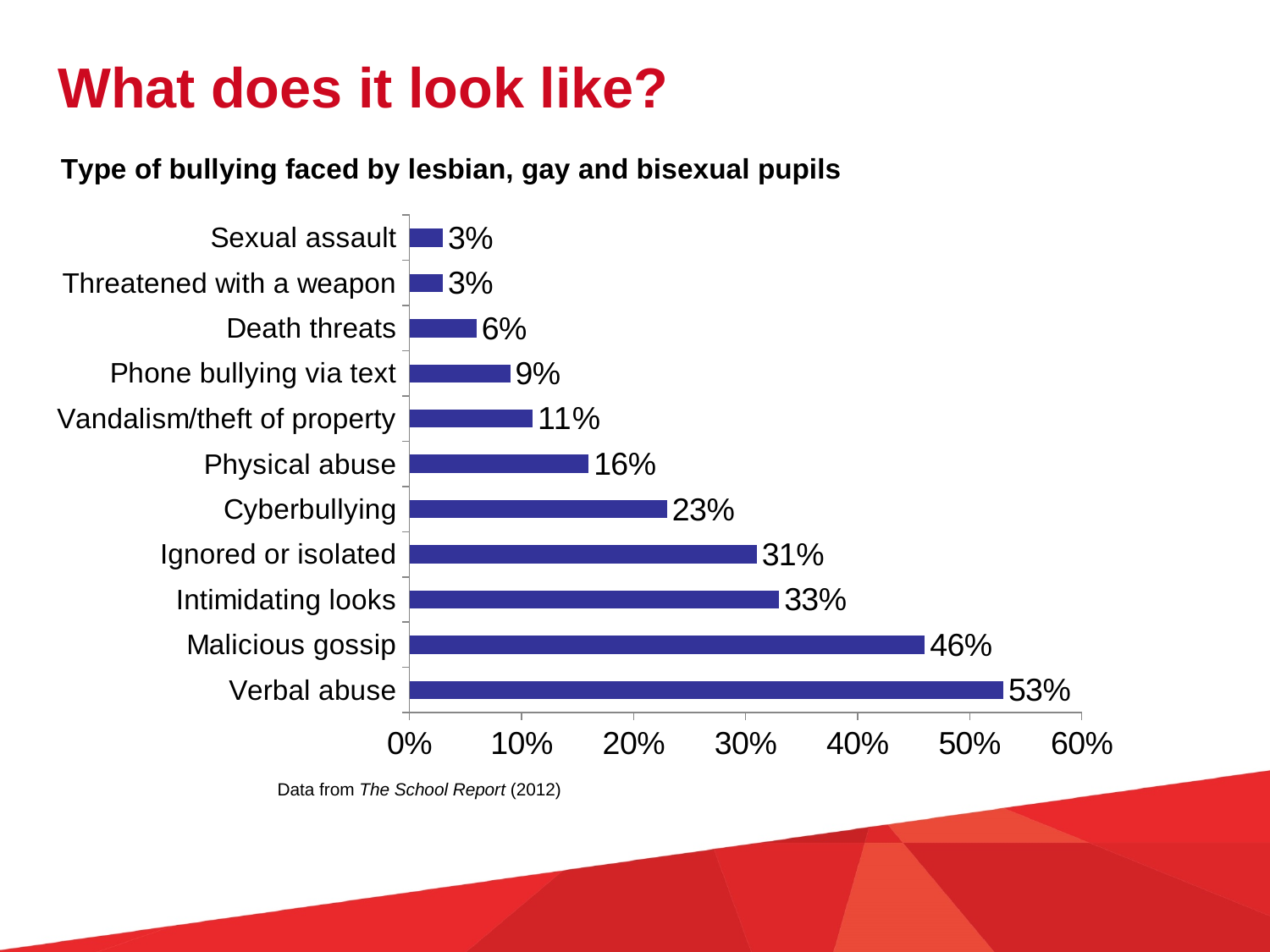
What is the value shown for Vandalism/theft of property? 11% What is the value shown for Cyberbullying? 23% What percentage of lesbian, gay and bisexual pupils faced verbal abuse? 53% What is the difference between the values for Physical abuse and Phone bullying via text? 7% Which type of bullying has the highest value? Verbal abuse How many types of bullying are shown in the chart? 11 What kind of chart is shown on the slide? Bar chart Which is larger, the value for Ignored or isolated or the value for Cyberbullying? Ignored or isolated What is the title of the chart? Type of bullying faced by lesbian, gay and bisexual pupils Which type of bullying has the lowest value, Death threats or Physical abuse? Death threats Is the value for Malicious gossip greater or less than 40%? greater What is the difference between the values for Malicious gossip and Intimidating looks? 13%